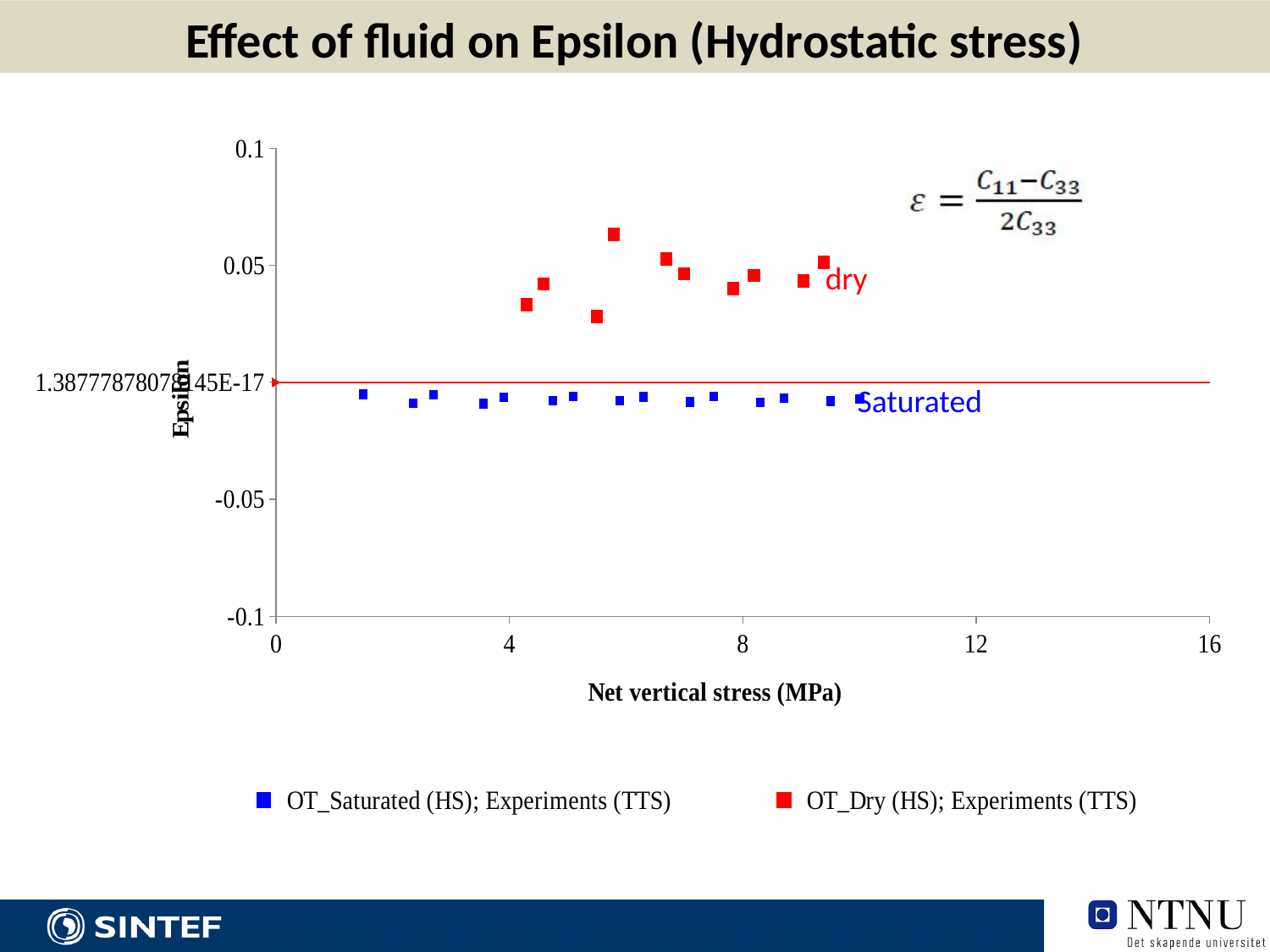
Are the epsilon values for the OT_Saturated series greater or less than -0.05? greater What colour are the markers for the OT_Saturated (HS); Experiments (TTS) series? blue Is the highest epsilon value for the OT_Dry series greater or less than 0.1? less Which series has the higher epsilon values, OT_Saturated or OT_Dry? OT_Dry What kind of chart is shown on the slide? scatter chart Are the epsilon values for the OT_Dry series greater or less than 0? greater How many series does the legend list? 2 What is the label of the x axis? Net vertical stress (MPa)